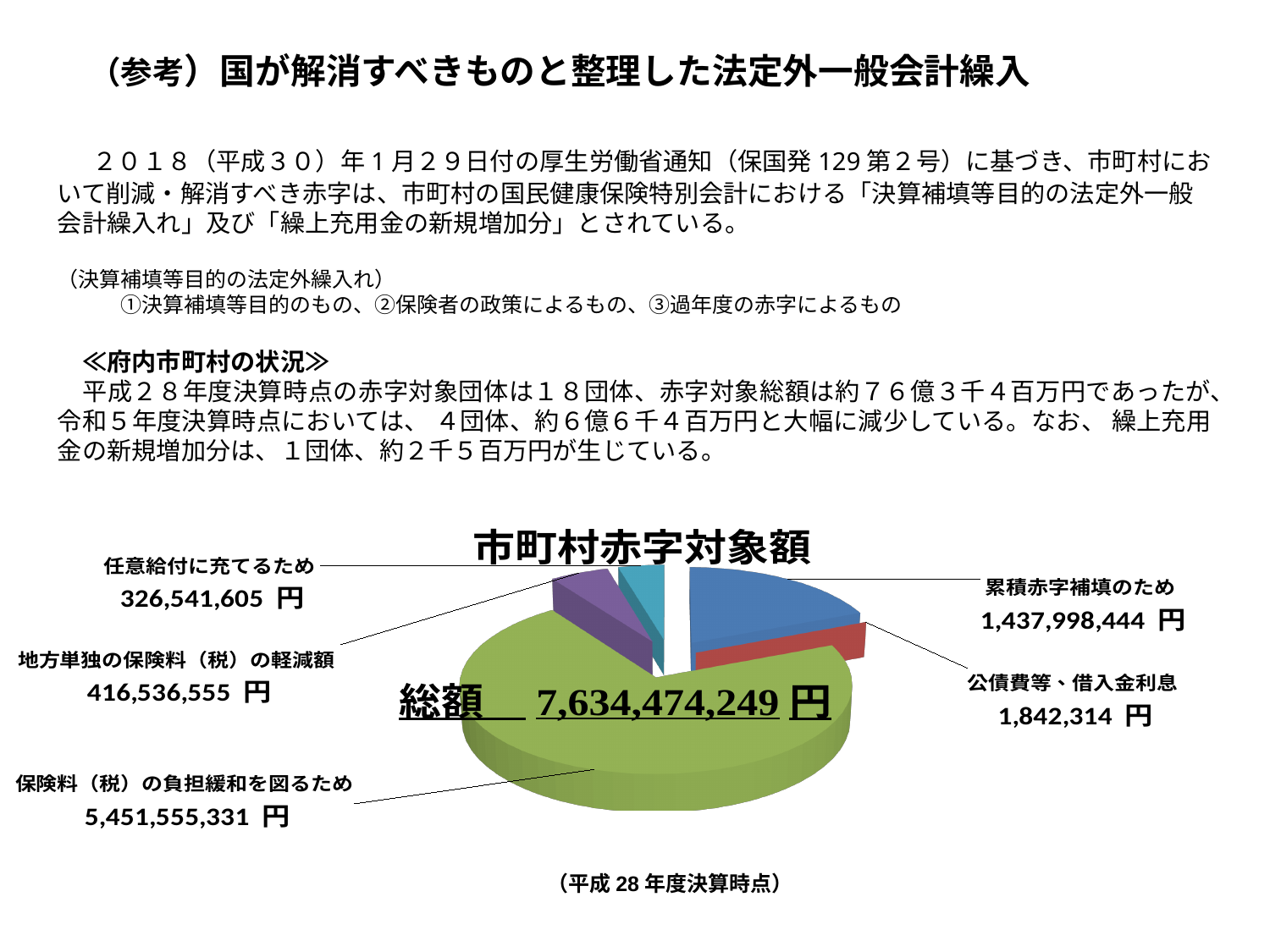
What is the total amount (総額) shown for the pie chart? 7,634,474,249 円 What is the value for 累積赤字補填のため in the pie chart 市町村赤字対象額? 1,437,998,444 円 Which is larger in the pie chart, 地方単独の保険料（税）の軽減額 or 任意給付に充てるため? 地方単独の保険料（税）の軽減額 What is the difference between 累積赤字補填のため and 任意給付に充てるため in the pie chart? 1,111,456,839 円 What kind of chart is shown on the slide? Pie chart How many categories are shown in the pie chart 市町村赤字対象額? 5 Which category has the largest slice in the pie chart 市町村赤字対象額? 保険料（税）の負担緩和を図るため Which category has the smallest slice in the pie chart? 公債費等、借入金利息 What is the value for 任意給付に充てるため in the pie chart? 326,541,605 円 What is the value for 公債費等、借入金利息 in the pie chart? 1,842,314 円 What is the title of the chart on the slide? 市町村赤字対象額 What is the value for 保険料（税）の負担緩和を図るため in the pie chart? 5,451,555,331 円